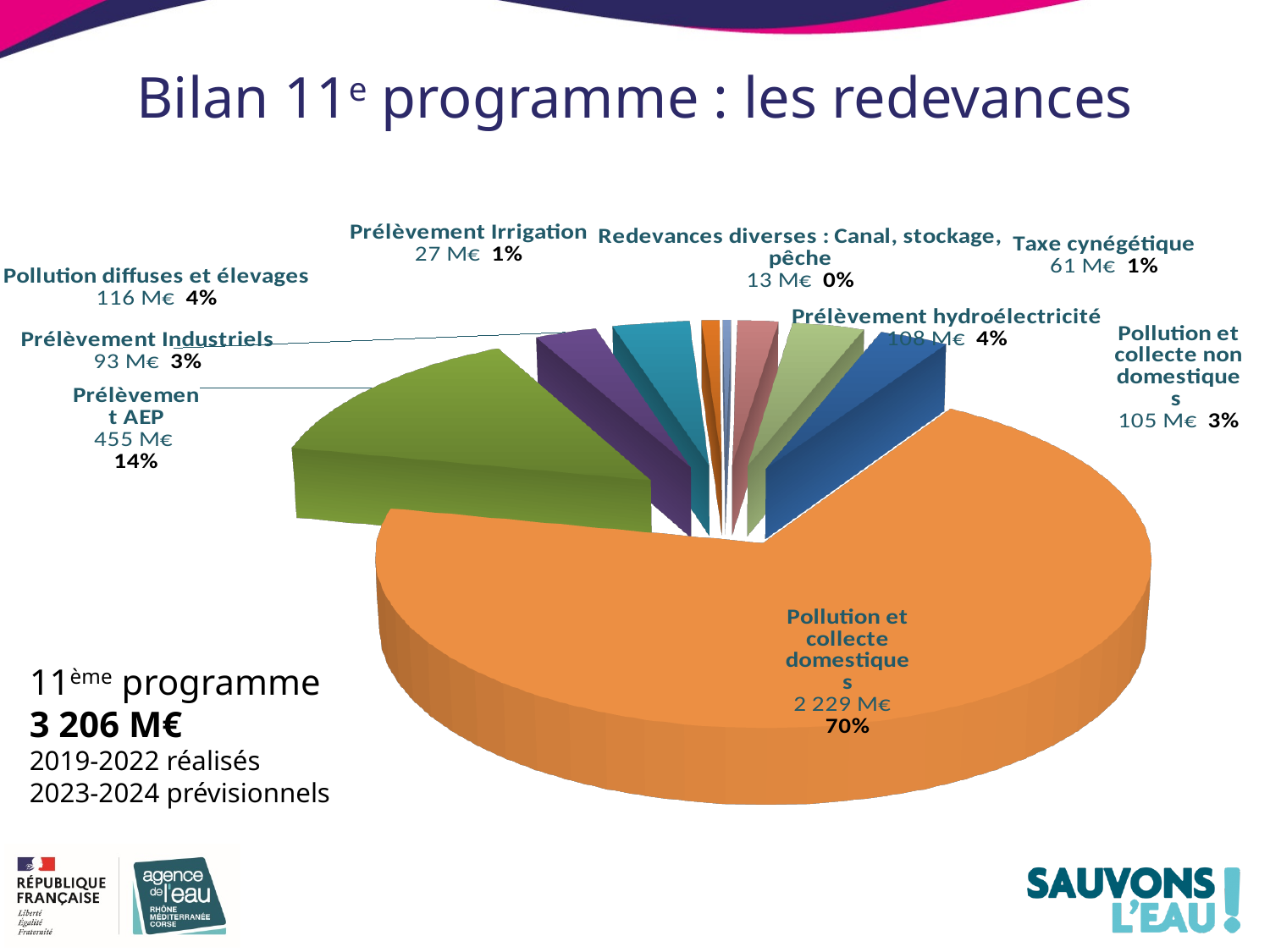
What is the value for Pollution diffuses et élevages? 116 M€ Which is larger, Pollution diffuses et élevages or Pollution et collecte non domestiques? Pollution diffuses et élevages What is the difference between Prélèvement AEP and Prélèvement Industriels? 362 M€ What type of chart is shown on the slide? pie chart What is the total amount of the 11ème programme stated on the slide? 3 206 M€ How many categories are shown in the pie chart? 9 Which category has the smallest slice of the pie? Redevances diverses : Canal, stockage, pêche Which category has the largest slice of the pie? Pollution et collecte domestiques What is the value for Pollution et collecte domestiques? 2 229 M€ What is the value for Taxe cynégétique? 61 M€ What share of the pie does Prélèvement AEP represent? 14% What share of the pie does Prélèvement Irrigation represent? 1%